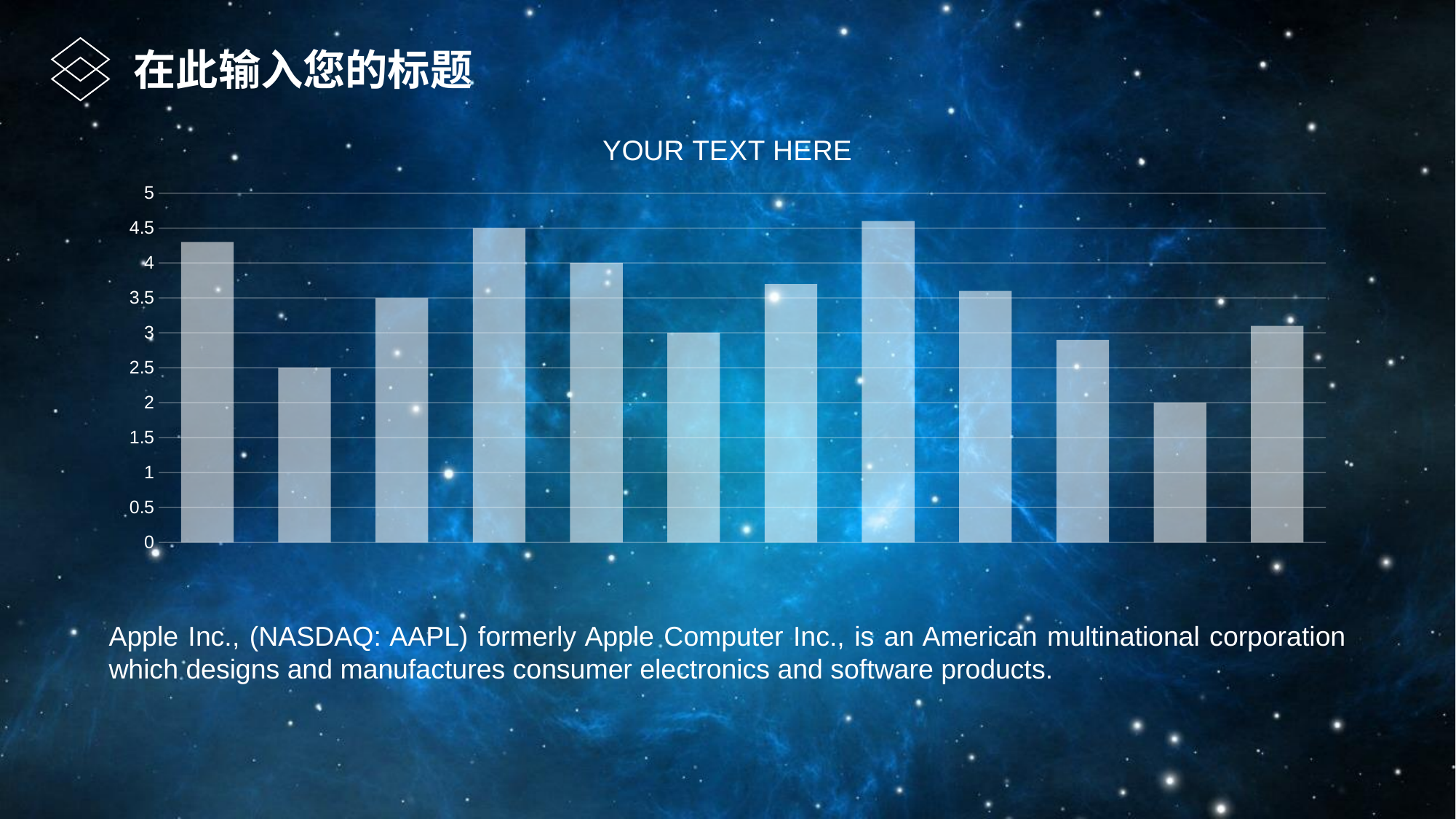
Which is taller, the first bar or the second bar from the left? the first bar What is the value of the second bar from the left? 2.5 Is the value of the tenth bar from the left greater or less than 3? less What is the value of the eleventh bar from the left? 2 Is the value of the first bar from the left greater or less than 4? greater What is the value of the third bar from the left? 3.5 Which bar is the lowest in the chart? the eleventh bar from the left What is the value of the fifth bar from the left? 4 How many bars does the chart contain? 12 What is the value of the sixth bar from the left? 3 What is the title of the chart? YOUR TEXT HERE What kind of chart is shown on the slide? bar chart